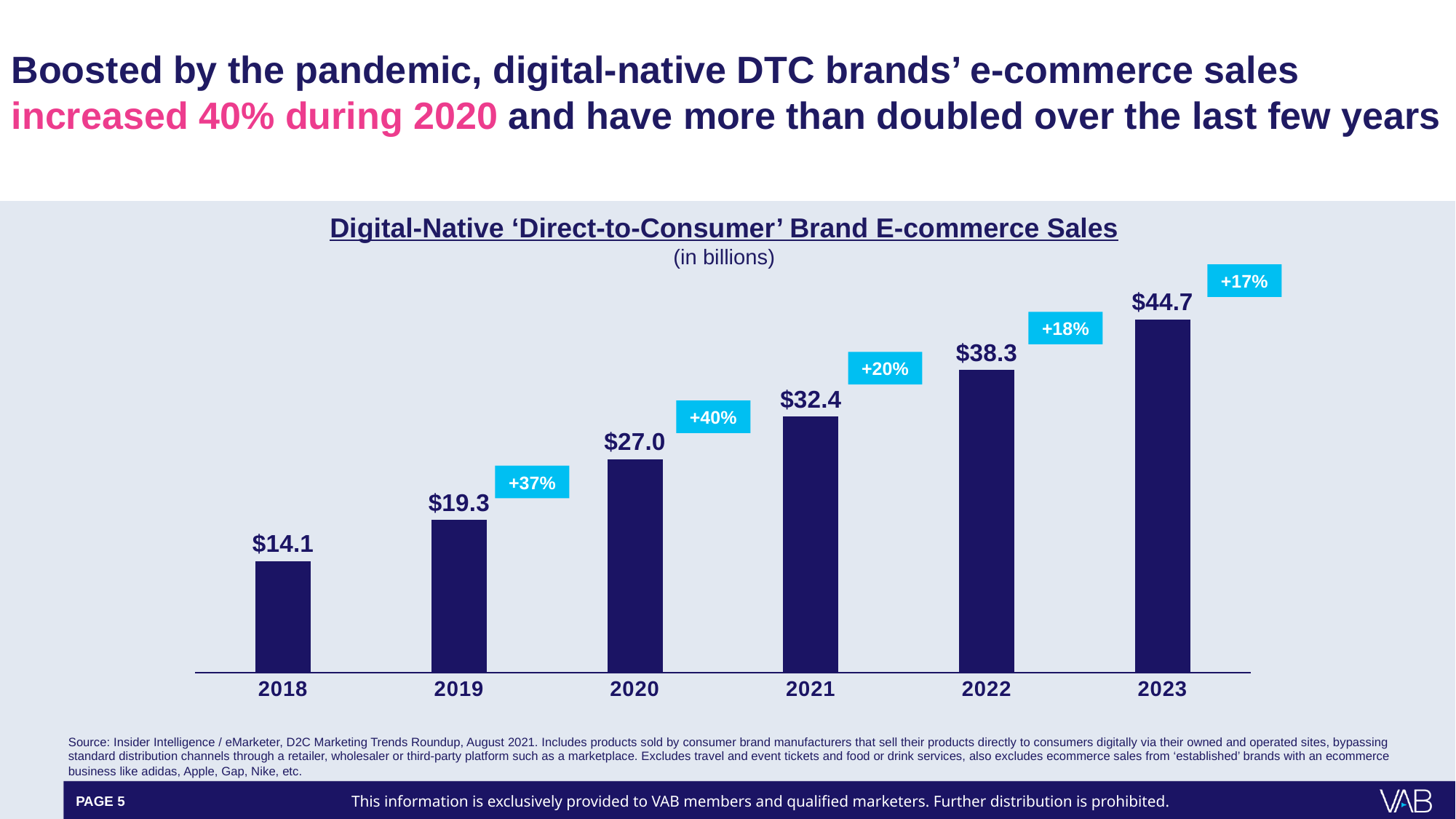
How many years are shown on the chart? 6 What is the value for 2020? $27.0 What is the value for 2018? $14.1 Which year has the highest value? 2023 Which year has the lowest value? 2018 What kind of chart is this? Bar chart Which is larger, the value for 2021 or the value for 2019? 2021 What percentage growth is shown for 2019? +37% What is the value for 2023? $44.7 What is the difference between the values for 2023 and 2022? $6.4 Do the values rise or fall from 2018 to 2023? Rise What is the difference between the values for 2020 and 2018? $12.9